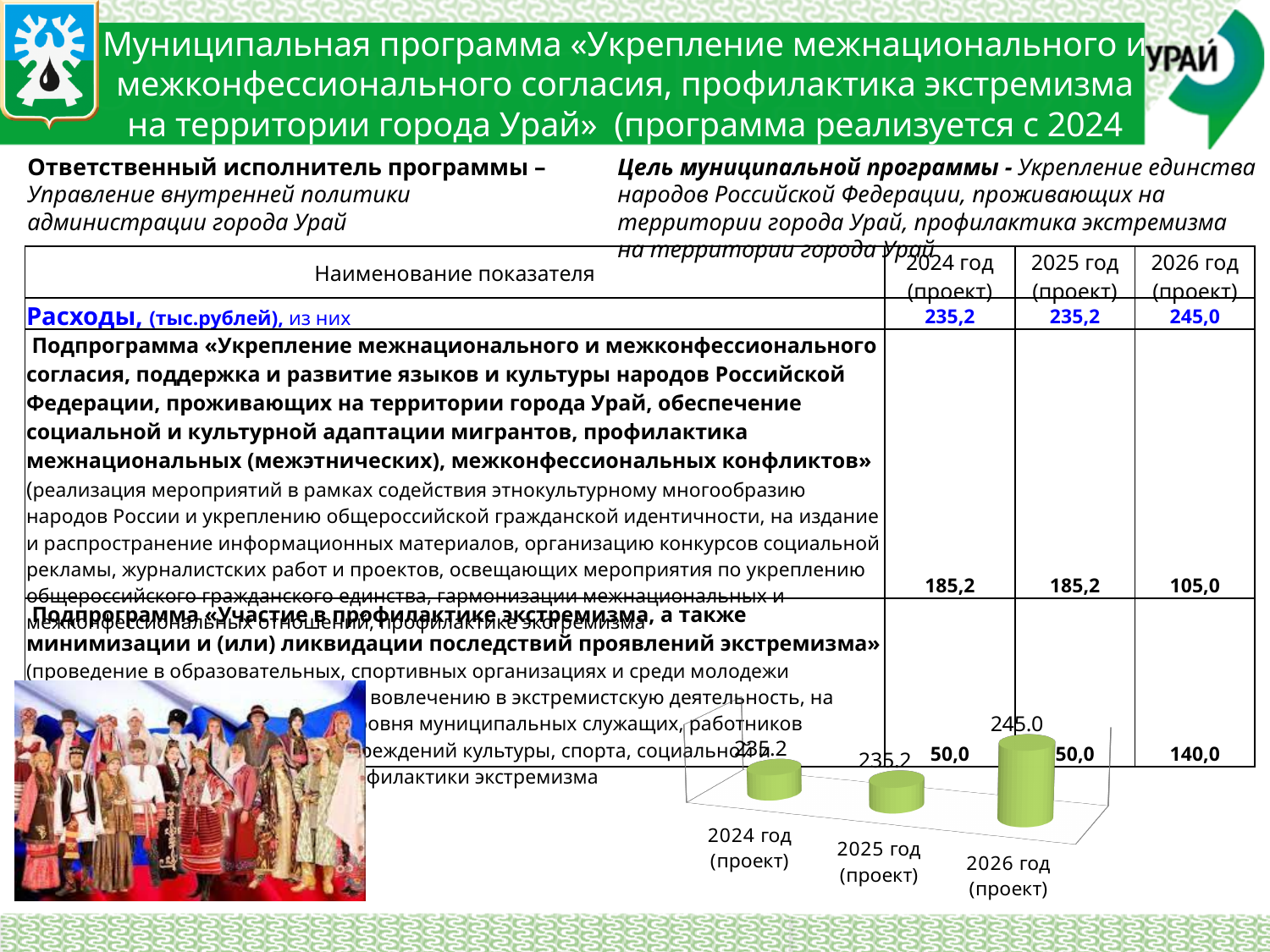
What kind of chart is shown on the slide? bar chart Are the values for 2024 год (проект) and 2025 год (проект) in the chart equal? yes What is the value shown for 2024 год (проект) in the chart? 235.2 Which category has the highest value in the chart? 2026 год (проект) What is the value shown for 2025 год (проект) in the chart? 235.2 What is the difference between the values for 2026 год (проект) and 2024 год (проект) in the chart? 9.8 What is the value shown for 2026 год (проект) in the chart? 245.0 What is the label of the first category on the x axis of the chart? 2024 год (проект) How many categories are plotted in the chart? 3 Which is larger in the chart, the value for 2024 год (проект) or for 2026 год (проект)? 2026 год (проект) Do the values in the chart rise or fall from 2024 год (проект) to 2026 год (проект)? rise